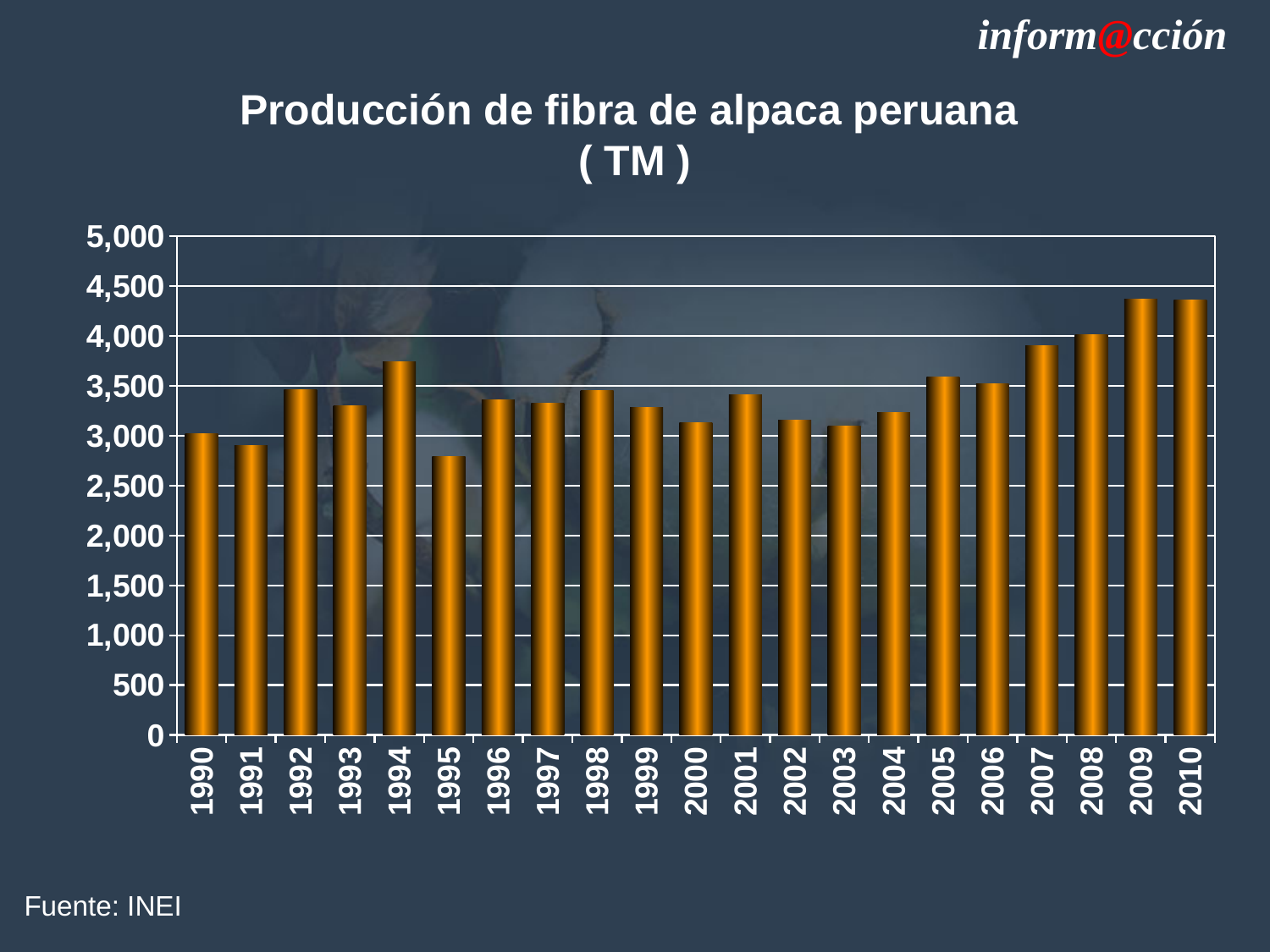
What is the title of the chart? Producción de fibra de alpaca peruana ( TM ) Is the value for 1995 greater or less than 3,000? less What kind of chart is shown on the slide? bar chart Is the value for 1991 greater or less than 3,000? less Which year has the larger value, 1994 or 1995? 1994 Which year has the lowest alpaca fibre production in the chart? 1995 How many years are plotted on the x axis of the chart? 21 Is the value for 2009 greater or less than 4,000? greater Which year has the larger value, 1990 or 2009? 2009 Do the values generally rise or fall from 2003 to 2009? rise